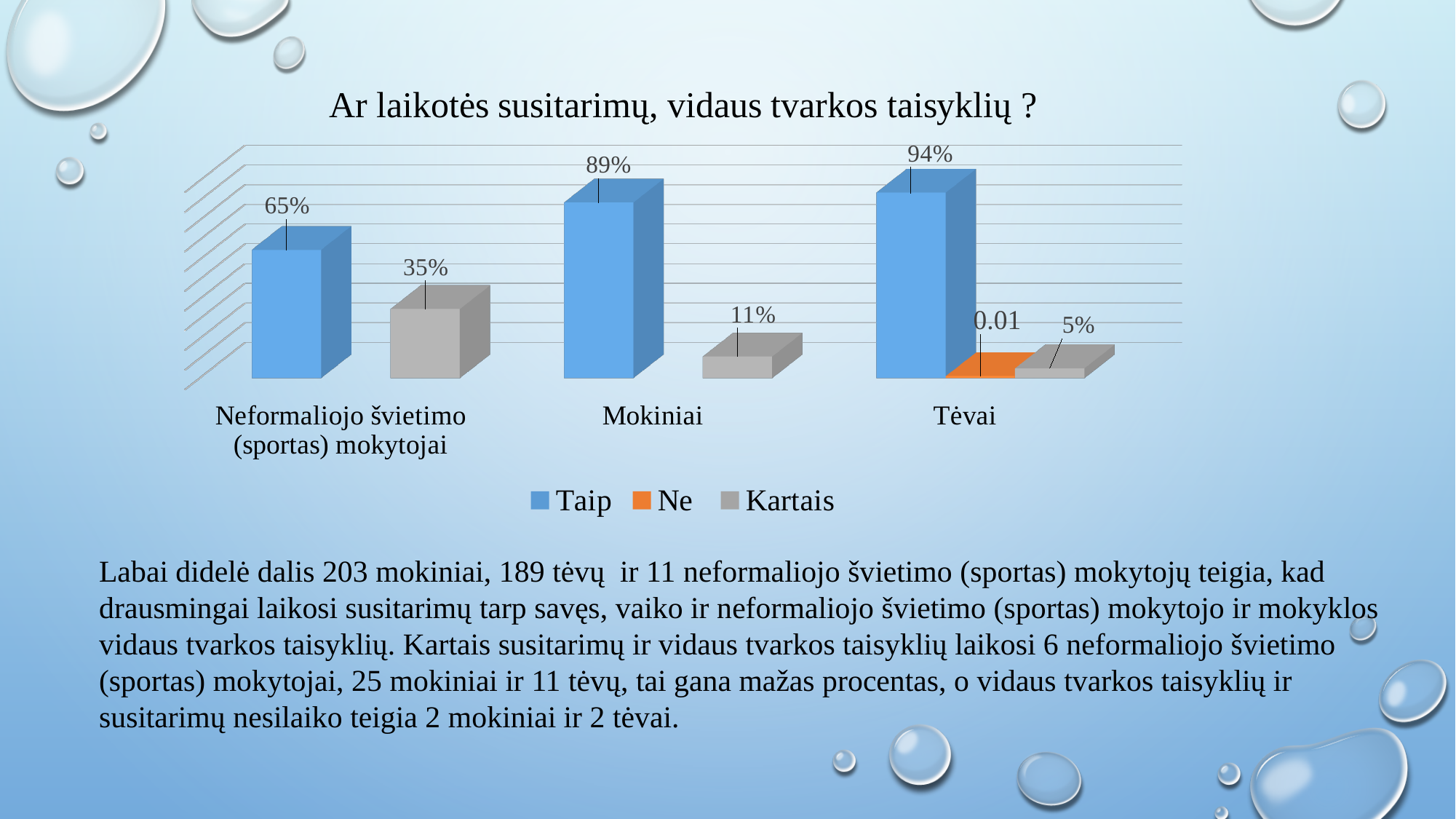
How many series does the legend list? 3 What is the value of the Kartais series for Tėvai? 5% What is the value of the Taip series for Tėvai? 94% Which category has the highest Taip value? Tėvai What type of chart is shown on the slide? Bar chart What is the difference between the Taip values for Tėvai and Neformaliojo švietimo (sportas) mokytojai? 29% What is the value of the Taip series for Mokiniai? 89% How many categories are shown on the x axis? 3 What is the value of the Kartais series for Neformaliojo švietimo (sportas) mokytojai? 35% Which is larger: the Kartais value for Mokiniai or the Kartais value for Neformaliojo švietimo (sportas) mokytojai? Neformaliojo švietimo (sportas) mokytojai What label is printed on the Ne bar for Tėvai? 0.01 Which category has the lowest Kartais value? Tėvai